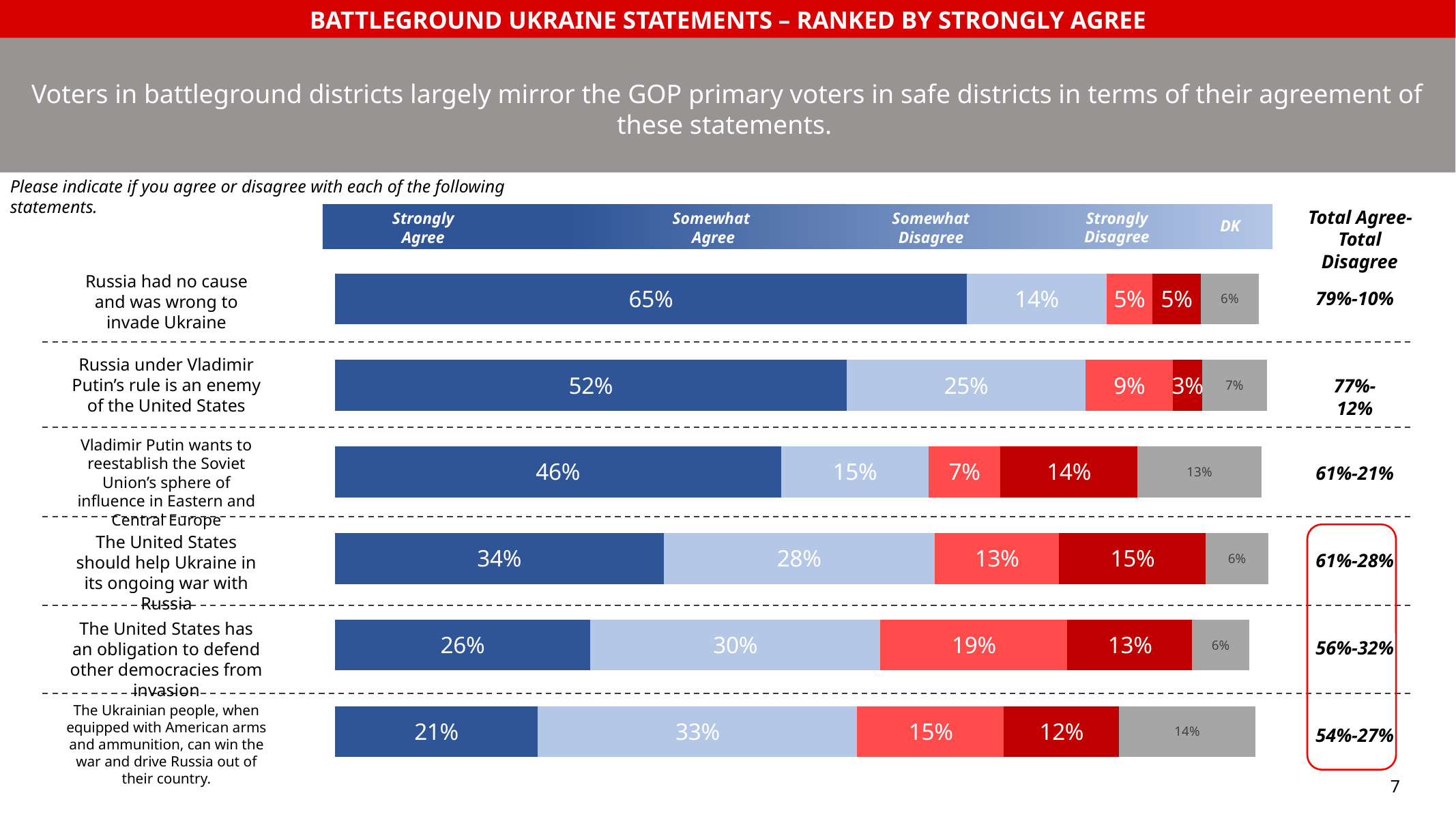
What is the Strongly Disagree value for the statement that the United States should help Ukraine in its ongoing war with Russia? 15% What is the DK value for the statement that Vladimir Putin wants to reestablish the Soviet Union's sphere of influence in Eastern and Central Europe? 13% How many response categories does the legend list? 5 What is the difference between the Strongly Agree percentages for 'Russia had no cause and was wrong to invade Ukraine' and 'Russia under Vladimir Putin's rule is an enemy of the United States'? 13% Which statement has the highest Strongly Agree percentage? Russia had no cause and was wrong to invade Ukraine Which statement has the lowest Strongly Agree percentage? The Ukrainian people, when equipped with American arms and ammunition, can win the war and drive Russia out of their country. What percentage somewhat agree that the United States has an obligation to defend other democracies from invasion? 30% What kind of chart is shown on the slide? Stacked bar chart What is the Total Agree-Total Disagree figure shown for the statement that Russia under Vladimir Putin's rule is an enemy of the United States? 77%-12% How many statements are shown in the chart? 6 What percentage strongly agree that Russia had no cause and was wrong to invade Ukraine? 65% Which is larger: the Somewhat Disagree value for 'The United States has an obligation to defend other democracies from invasion' or the Somewhat Disagree value for 'The United States should help Ukraine in its ongoing war with Russia'? The United States has an obligation to defend other democracies from invasion